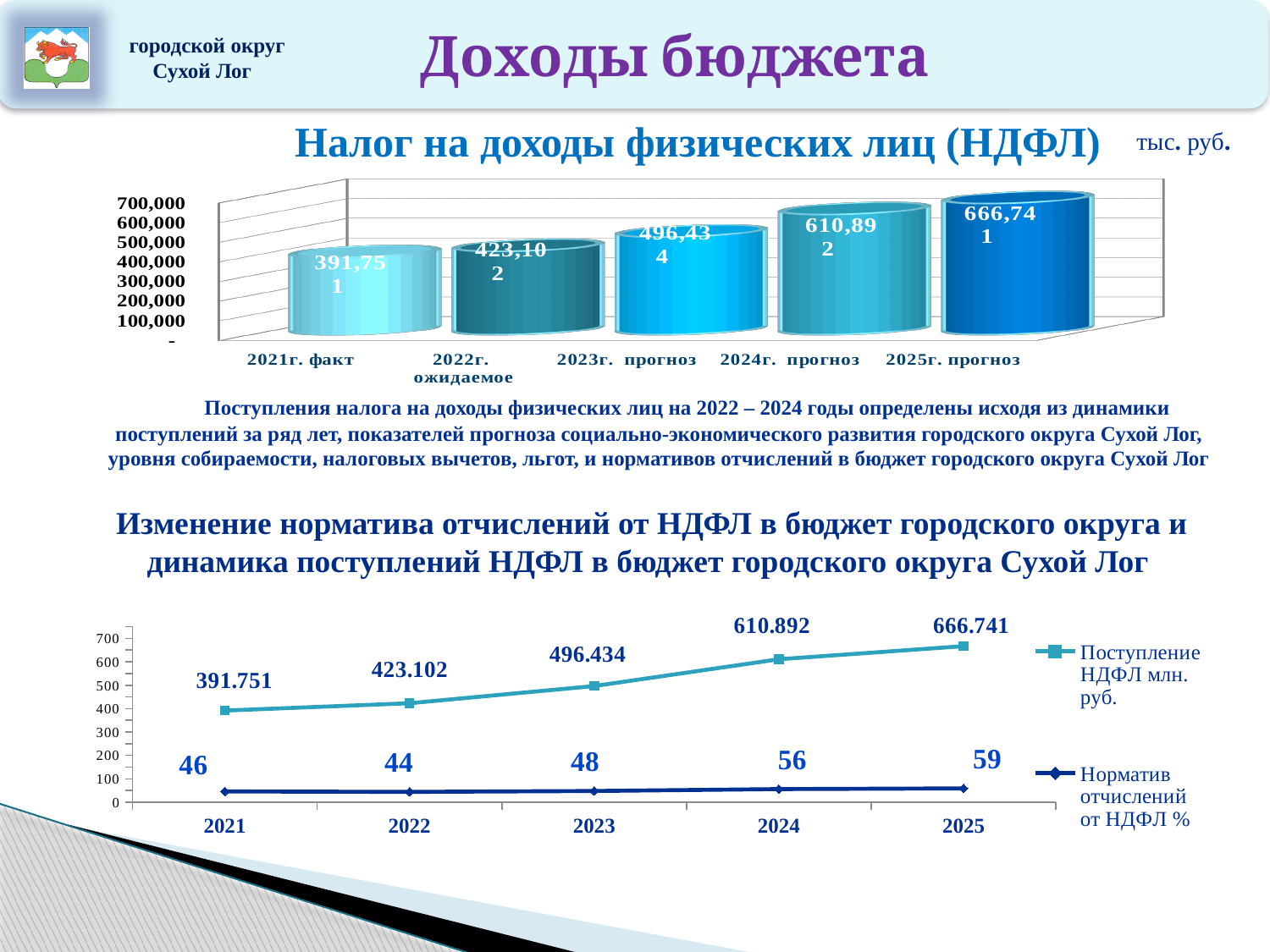
In the top chart (Налог на доходы физических лиц), do the values rise or fall from 2021 to 2025? rise In the bottom chart, what is the difference between the Норматив отчислений от НДФЛ % values for 2025 and 2021? 13 In the bottom chart, what is the value of Норматив отчислений от НДФЛ % for 2022? 44 In the top chart (Налог на доходы физических лиц), what is the value for 2025г. прогноз? 666,741 In the top chart (Налог на доходы физических лиц), how many bars are shown? 5 In the bottom chart, what kind of chart is it? line chart In the top chart (Налог на доходы физических лиц), what kind of chart is it? bar chart In the top chart (Налог на доходы физических лиц), which year has the lowest value? 2021г. факт In the bottom chart, which year has the highest Норматив отчислений от НДФЛ %? 2025 In the top chart (Налог на доходы физических лиц), what is the value for 2021г. факт? 391,751 In the bottom chart, what is the value of Поступление НДФЛ млн. руб. for 2024? 610.892 In the bottom chart, how many series does the legend list? 2